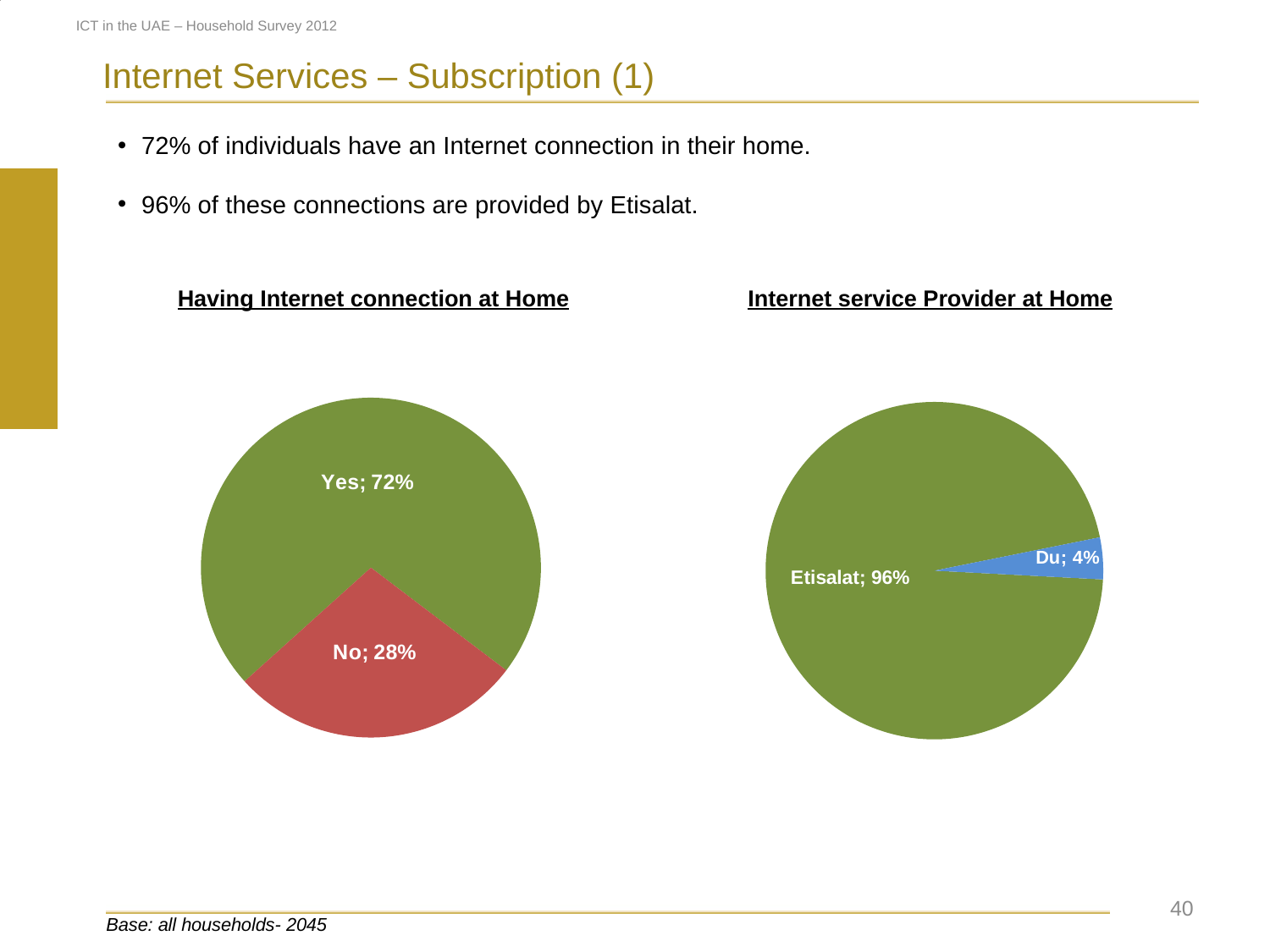
In the 'Having Internet connection at Home' chart, what percentage of households answered Yes? 72% In the 'Internet service Provider at Home' chart, what share of connections are provided by Du? 4% In the 'Internet service Provider at Home' chart, what is the difference in percentage points between Etisalat and Du? 92 In the 'Having Internet connection at Home' chart, which slice is the largest? Yes In the 'Having Internet connection at Home' chart, what percentage of households answered No? 28% In the 'Internet service Provider at Home' chart, what share of connections are provided by Etisalat? 96% In the 'Internet service Provider at Home' chart, which provider has the smallest slice? Du In the 'Having Internet connection at Home' chart, which is larger, Yes or No? Yes What type of chart is the 'Having Internet connection at Home' chart? Pie chart In the 'Having Internet connection at Home' chart, what is the difference in percentage points between Yes and No? 44 In the 'Internet service Provider at Home' chart, what colour is the Du slice? Blue How many slices does the 'Internet service Provider at Home' chart have? 2